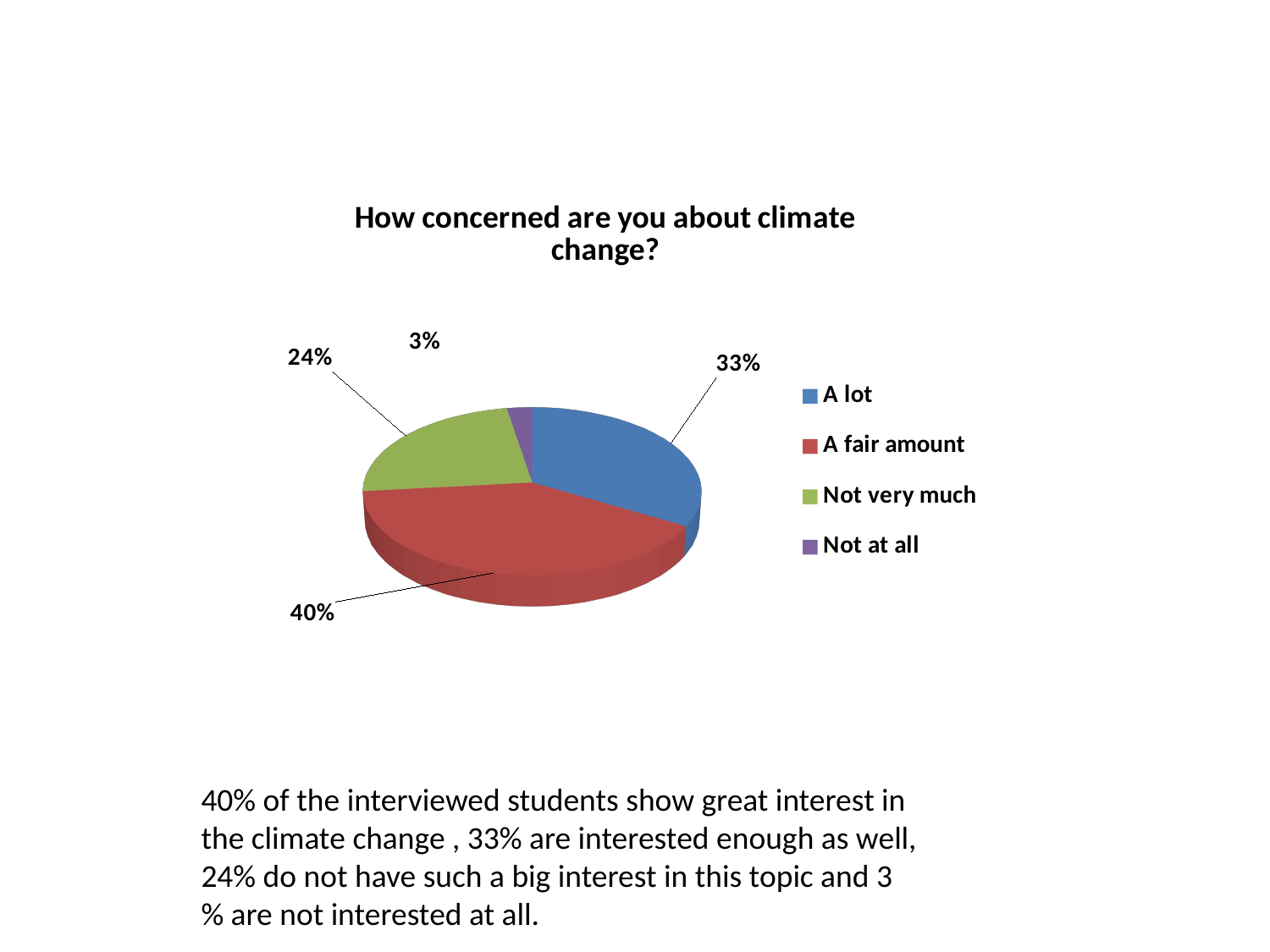
What colour is the 'Not very much' slice? Green What percentage of the pie is labelled for the 'A fair amount' slice? 40% Which is larger, the 'Not very much' share or the 'A lot' share? A lot What is the title of the chart? How concerned are you about climate change? Which category has the largest share of the pie? A fair amount Which category has the smallest share of the pie? Not at all What is the difference between the 'A fair amount' share and the 'A lot' share? 7% What percentage of the pie is labelled for the 'A lot' slice? 33% What percentage of the pie is labelled for the 'Not at all' slice? 3% How many categories does the legend list? 4 What kind of chart is shown on the slide? Pie chart What percentage of the pie is labelled for the 'Not very much' slice? 24%